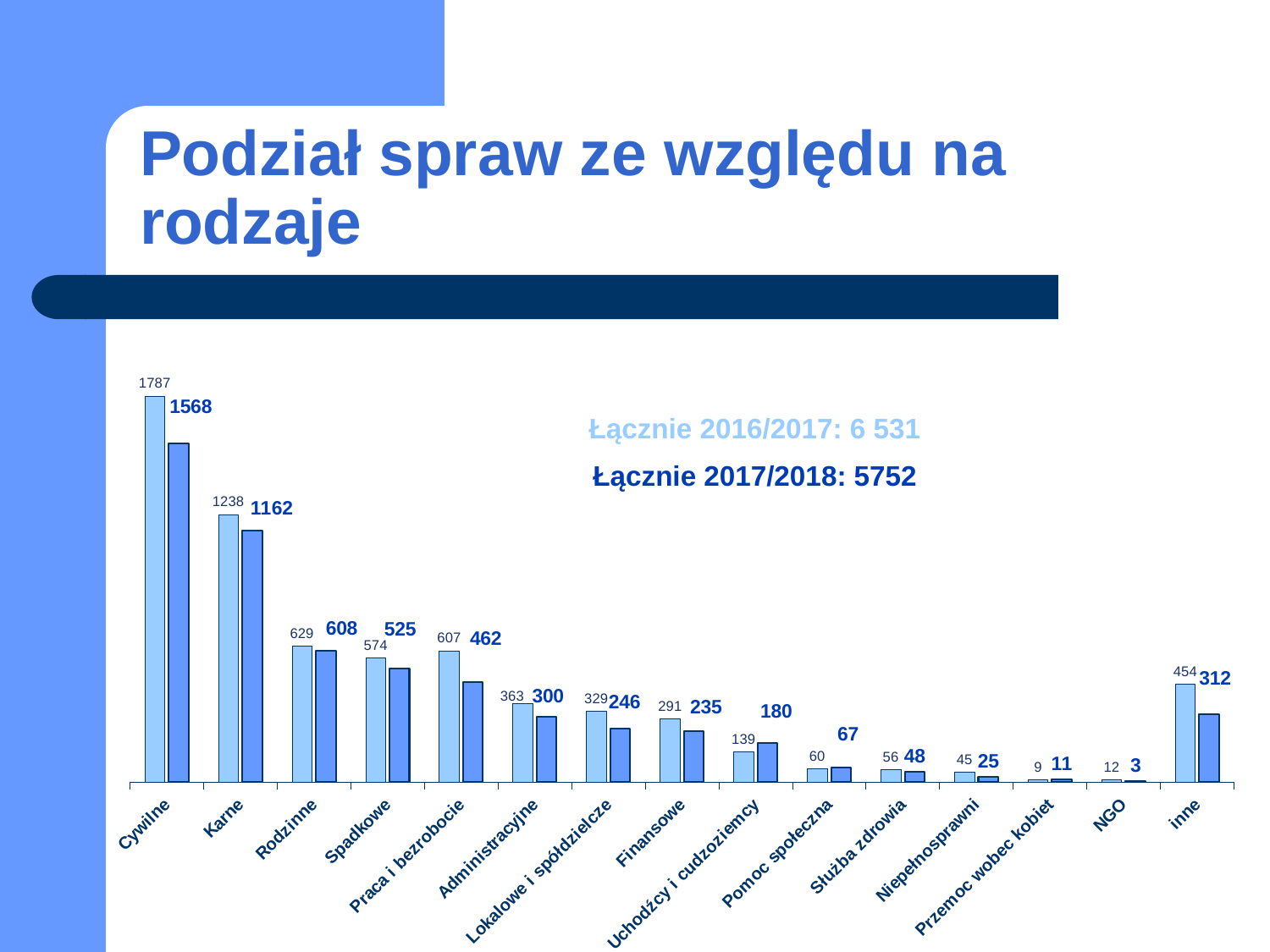
What is the difference between the light blue and dark blue values for Cywilne? 219 For Uchodźcy i cudzoziemcy, which bar is larger, the light blue or the dark blue one? dark blue What is the difference between the light blue and dark blue values for Rodzinne? 21 Which category has the highest bars in the chart? Cywilne How many categories are shown on the x axis of the chart? 15 What total is given on the slide for 2017/2018 (Łącznie 2017/2018)? 5752 What is the value of the light blue (2016/2017) bar for Karne? 1238 Which has the larger light blue (2016/2017) value, Spadkowe or Praca i bezrobocie? Praca i bezrobocie What kind of chart is shown on the slide? bar chart Which category has the lowest dark blue (2017/2018) value? NGO What is the value of the dark blue (2017/2018) bar for Praca i bezrobocie? 462 What is the value of the dark blue (2017/2018) bar for inne? 312